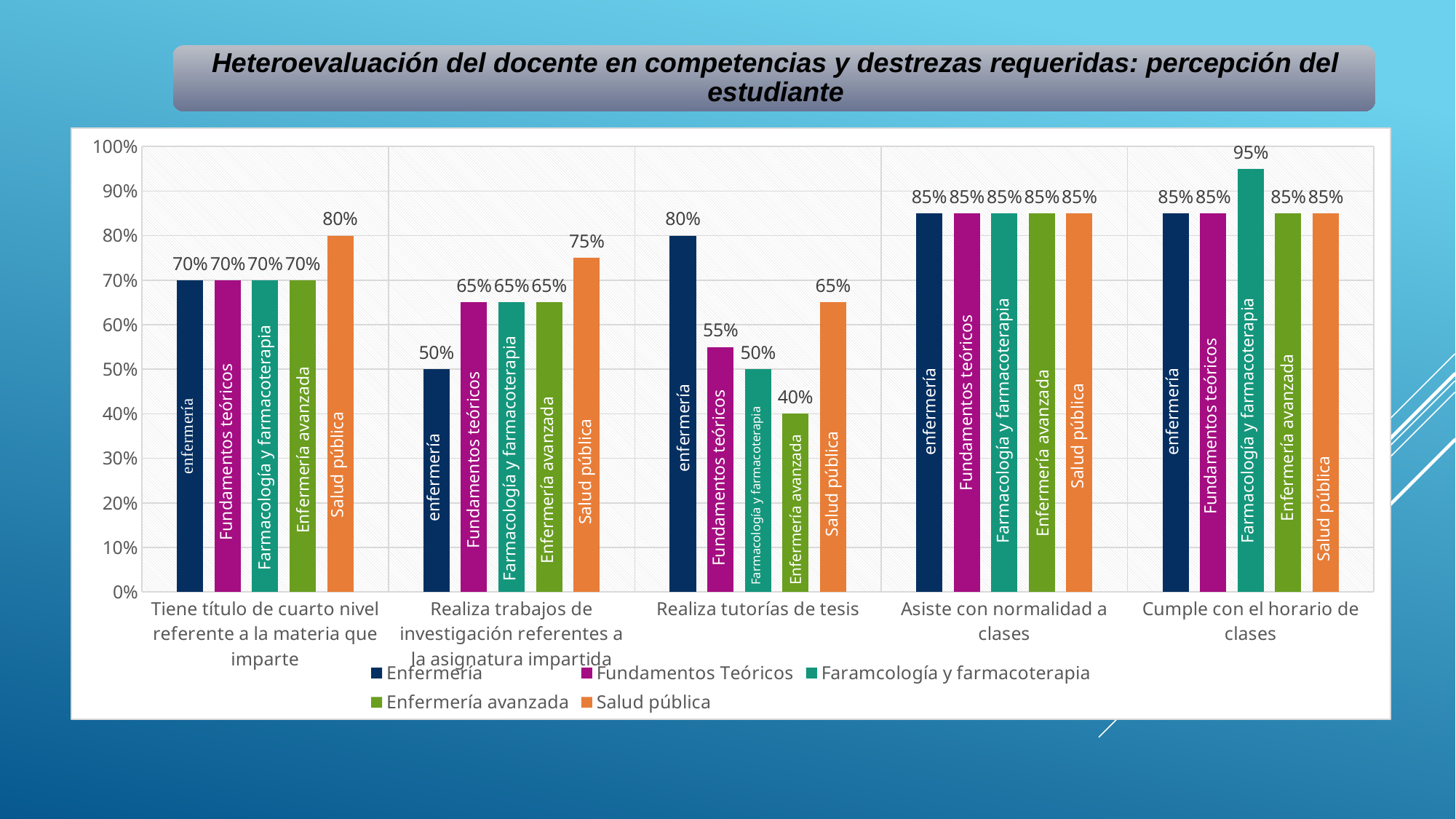
What is the value for Enfermería avanzada in the category "Realiza tutorías de tesis"? 40% What is the value for Enfermería in the category "Realiza trabajos de investigación referentes a la asignatura impartida"? 50% How many categories are shown on the x axis of the chart? 5 What kind of chart is shown on the slide? Bar chart What colour are the bars for the Salud pública series? Orange What is the difference between the Enfermería value and the Enfermería avanzada value in the category "Realiza tutorías de tesis"? 40% In the category "Realiza trabajos de investigación referentes a la asignatura impartida", which is larger: the value for Salud pública or the value for Enfermería? Salud pública What is the value for Salud pública in the category "Tiene título de cuarto nivel referente a la materia que imparte"? 80% How many series does the legend list? 5 Which series has the lowest value in the category "Realiza tutorías de tesis"? Enfermería avanzada What is the value for Fundamentos Teóricos in the category "Asiste con normalidad a clases"? 85% Which series has the highest value in the category "Cumple con el horario de clases"? Farmacología y farmacoterapia